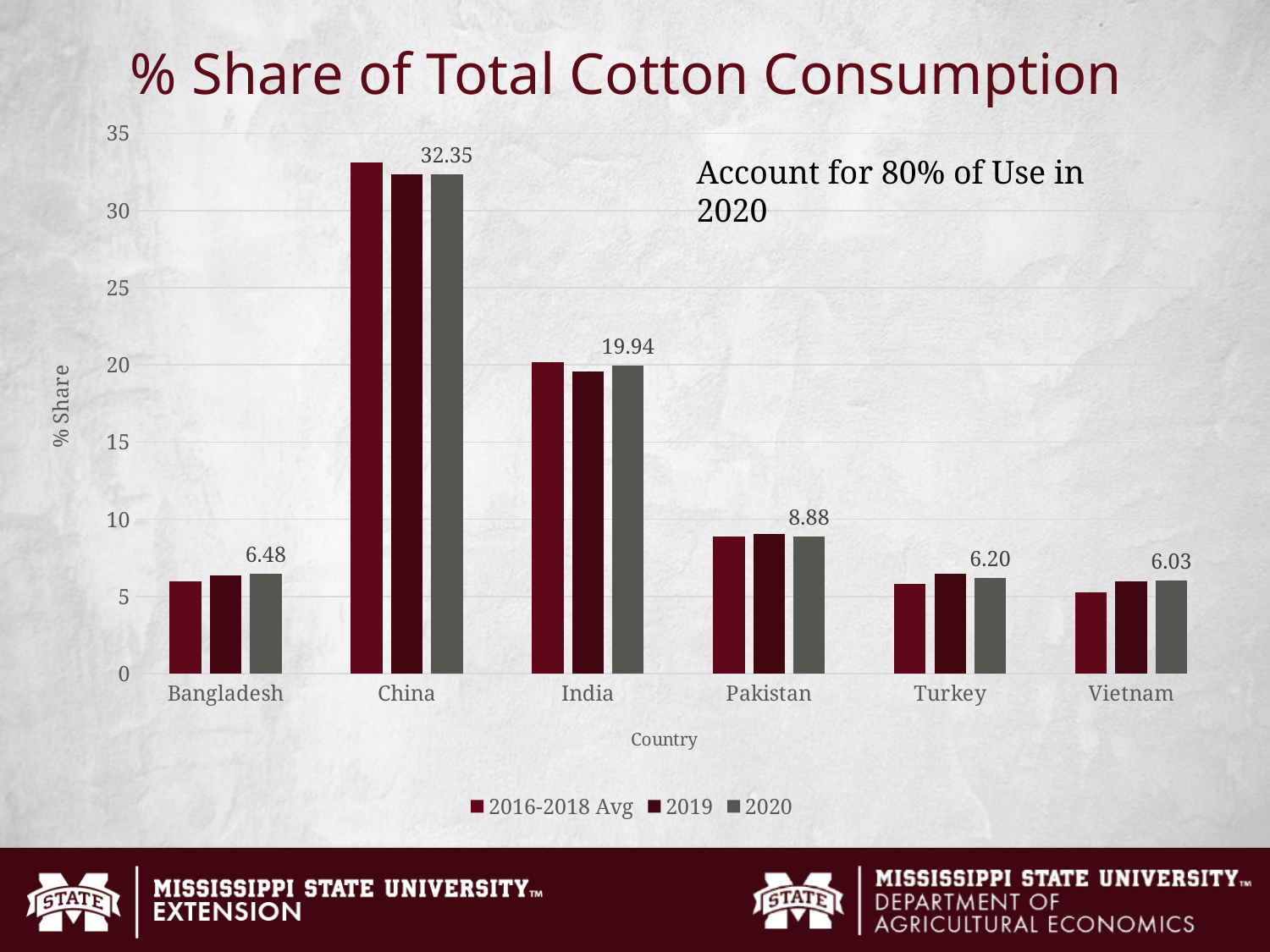
Which country has the lowest 2020 share of total cotton consumption? Vietnam Is the 2016-2018 Avg value for China greater or less than 30? greater How many series does the legend list? 3 What is the 2020 value for India? 19.94 What is the 2020 value for Pakistan? 8.88 What kind of chart is shown on the slide? bar chart What is the 2020 value for Bangladesh? 6.48 What is the difference between the 2020 values for China and India? 12.41 Which is larger, the 2020 value for Turkey or the 2020 value for Vietnam? Turkey What is the 2020 value for China? 32.35 Which country has the highest 2020 share of total cotton consumption? China How many countries are shown on the x axis? 6